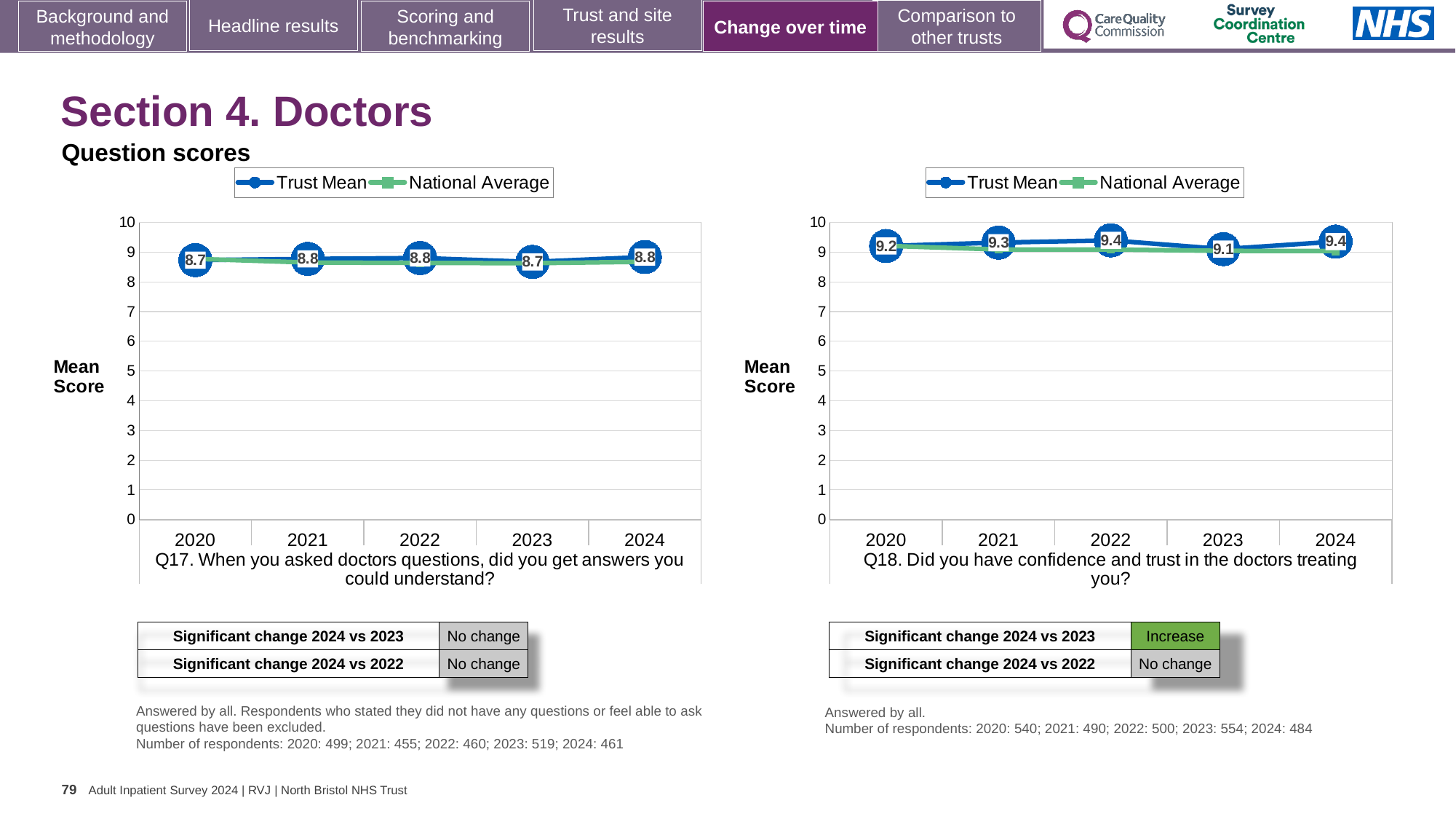
What type of chart is used for Q18? Line chart In the Q18 chart, what is the Trust Mean score for 2022? 9.4 In the Q17 chart, what is the difference between the Trust Mean scores for 2021 and 2020? 0.1 In the Q18 chart, what is the difference between the Trust Mean scores for 2024 and 2023? 0.3 In the Q17 chart, is the Trust Mean value for 2022 greater or less than 8? greater In the Q18 chart, is the Trust Mean score for 2021 larger or smaller than the score for 2023? larger How many series does the legend of the Q17 chart list? 2 How many years are shown on the x axis of the Q18 chart? 5 In the Q17 chart, what is the Trust Mean score for 2020? 8.7 In the Q17 chart, what is the Trust Mean score for 2024? 8.8 In the Q18 chart, which year has the lowest Trust Mean score? 2023 In the Q18 chart, what is the Trust Mean score for 2023? 9.1